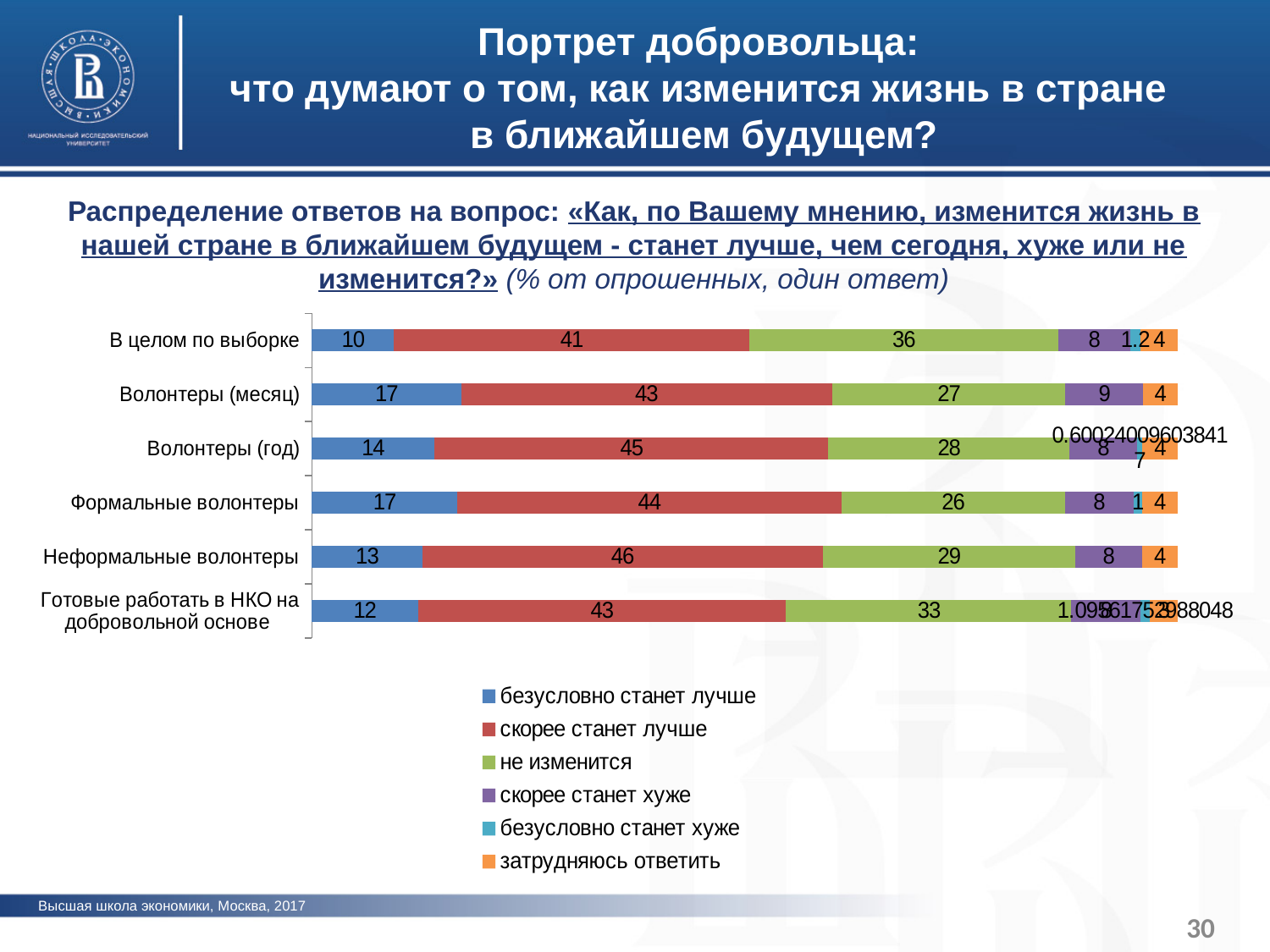
Which category has the lowest value for «безусловно станет лучше»? В целом по выборке What type of chart is shown on the slide? Stacked bar chart What is the value of «не изменится» for «В целом по выборке»? 36 Which has a larger value for «не изменится»: «Готовые работать в НКО на добровольной основе» or «Формальные волонтеры»? Готовые работать в НКО на добровольной основе How many categories (bars) are shown in the chart? 6 How many series does the legend list? 6 For «В целом по выборке», what is the difference between «скорее станет лучше» and «безусловно станет лучше»? 31 What is the value of «скорее станет хуже» for «Волонтеры (месяц)»? 9 Which category has the highest value for «скорее станет лучше»? Неформальные волонтеры What is the value of «скорее станет лучше» for «Неформальные волонтеры»? 46 What is the value of «безусловно станет лучше» for «Волонтеры (месяц)»? 17 What colour represents «не изменится» in the chart? Green